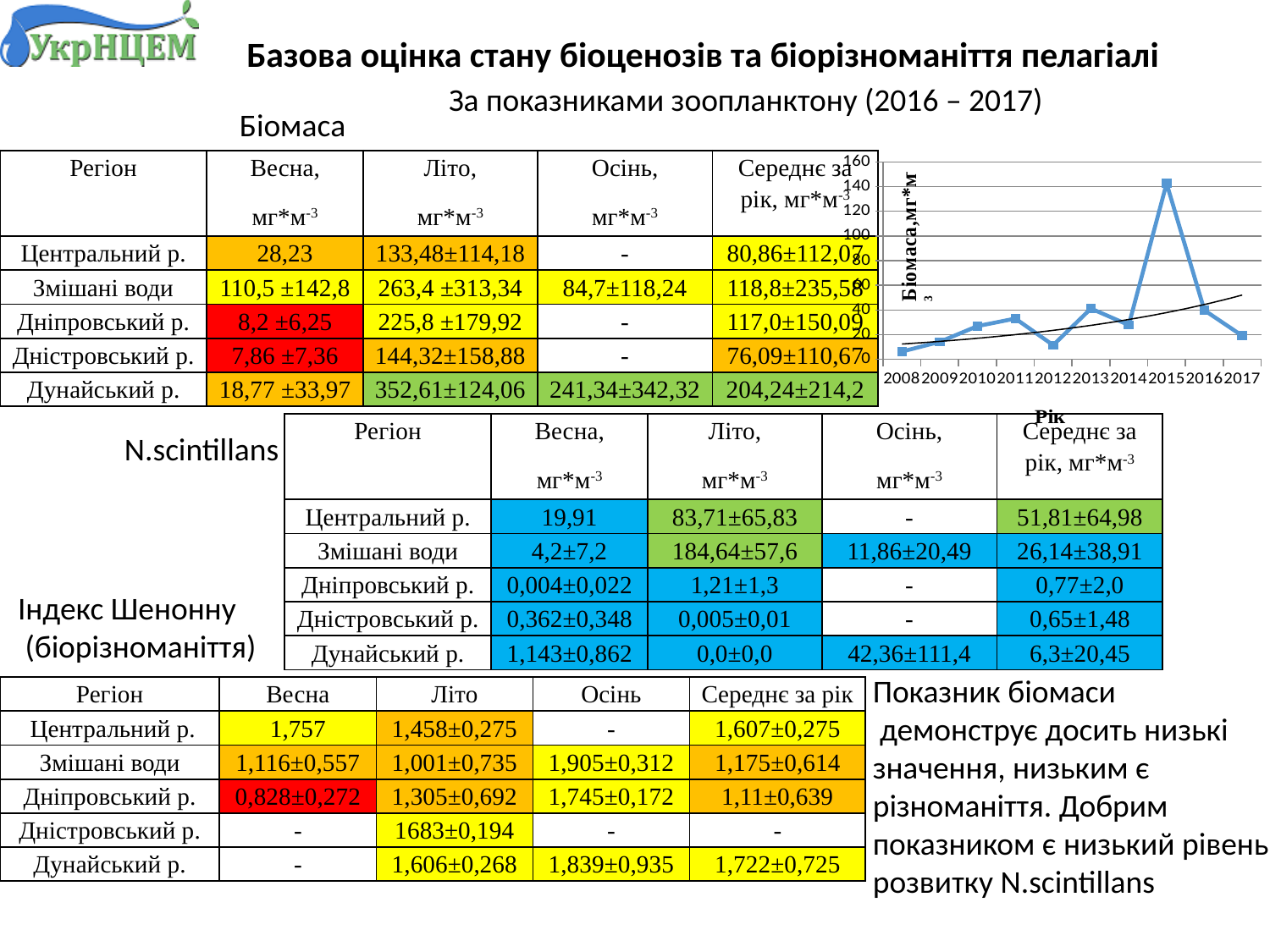
In the line chart, which year has the highest biomass value? 2015 What is the title of the x axis of the line chart? Рік In the line chart, is the value for 2008 greater or less than 20? less In the line chart, is the value for 2013 greater or less than 20? greater In the line chart, is the value for 2015 greater or less than 100? greater What kind of chart is shown in the top right of the slide? line chart How many years are plotted along the x axis of the line chart? 10 In the line chart, which is larger, the value for 2015 or the value for 2016? 2015 In the line chart, do the values rise or fall from 2015 to 2017? fall In the line chart, which is larger, the value for 2013 or the value for 2012? 2013 What is the first year shown on the x axis of the line chart? 2008